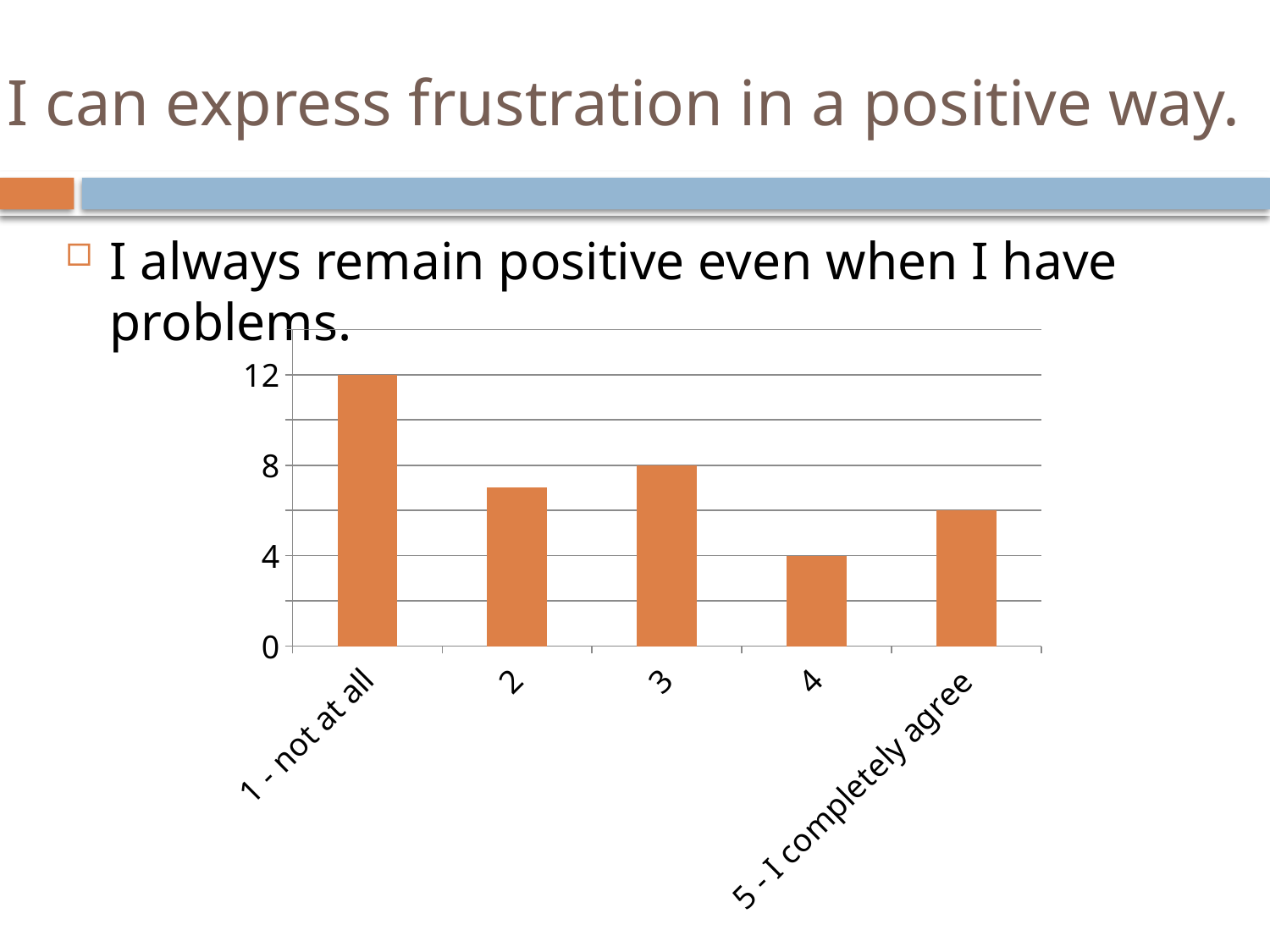
What is the value for category 3? 8 What is the value for the category "1 - not at all"? 12 What kind of chart is shown on the slide? bar chart Which is larger, the value for category 2 or the value for category 4? 2 What is the difference between the values for "1 - not at all" and category 3? 4 How many categories are shown on the x axis? 5 What is the difference between the values for "1 - not at all" and category 4? 8 Which category has the lowest value? 4 Which category has the highest value? 1 - not at all What is the value for category 4? 4 Is the value for "5 - I completely agree" greater or less than 4? greater Is the value for category 2 greater or less than 8? less